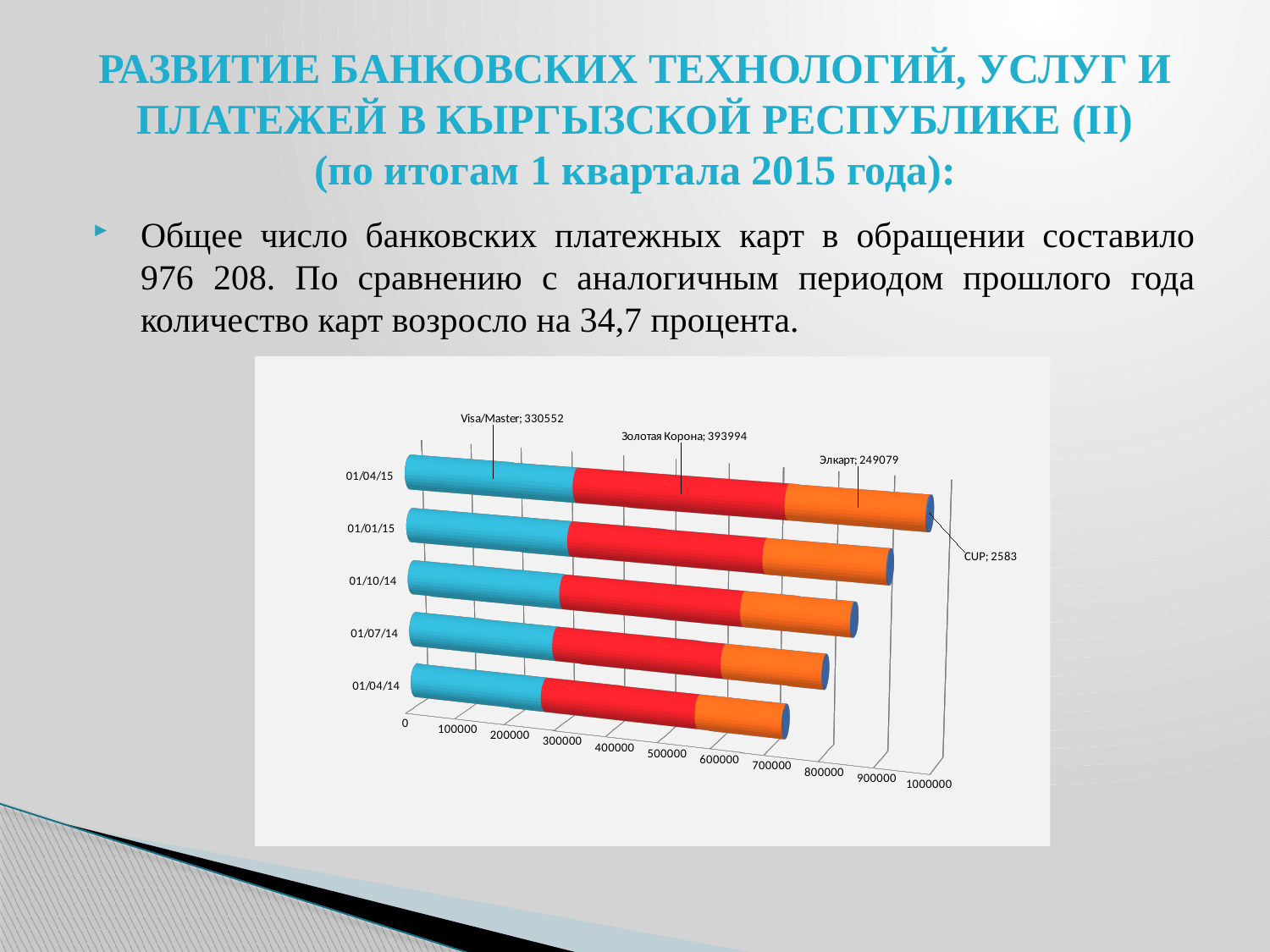
What is the total of the stacked bar for 01/04/15? 976208 What is the value for Элкарт on 01/04/15? 249079 What is the difference between Золотая Корона and Visa/Master on 01/04/15? 63442 What is the value for Золотая Корона on 01/04/15? 393994 Do the total bar lengths rise or fall from 01/04/14 to 01/04/15? Rise Which date has the longest total bar in the chart? 01/04/15 On 01/04/15, which is larger: Visa/Master or Золотая Корона? Золотая Корона Which date has the shortest total bar in the chart? 01/04/14 How many dates (categories) are shown on the vertical axis of the chart? 5 What is the value for Visa/Master on 01/04/15? 330552 What is the value for CUP on 01/04/15? 2583 What kind of chart is shown on the slide? Stacked bar chart